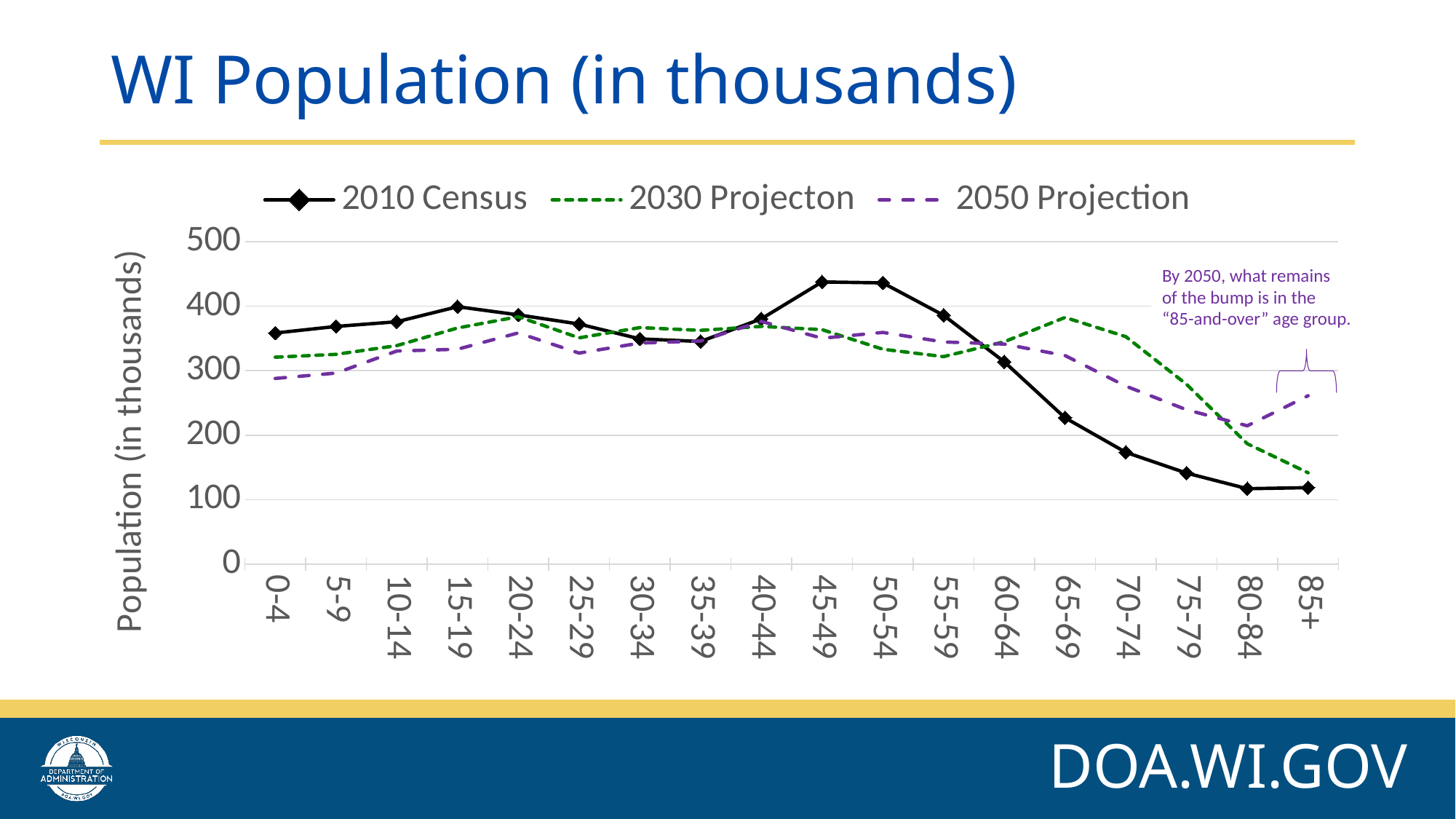
For the 85+ age group, which is larger: the 2030 Projection or the 2050 Projection? 2050 Projection Which series has the highest value for the 85+ age group? 2050 Projection Is the 2010 Census value for the 70-74 age group greater or less than 200? less How many age groups are shown on the x axis? 18 How many series does the legend list? 3 Does the 2010 Census line rise or fall from the 50-54 age group to the 85+ age group? fall Is the 2010 Census value for the 85+ age group greater or less than 200? less Is the 2010 Census value for the 45-49 age group greater or less than 400? greater What kind of chart is shown on the slide? line chart For the 0-4 age group, which is larger: the 2010 Census or the 2050 Projection? 2010 Census What is the title of the chart? WI Population (in thousands)